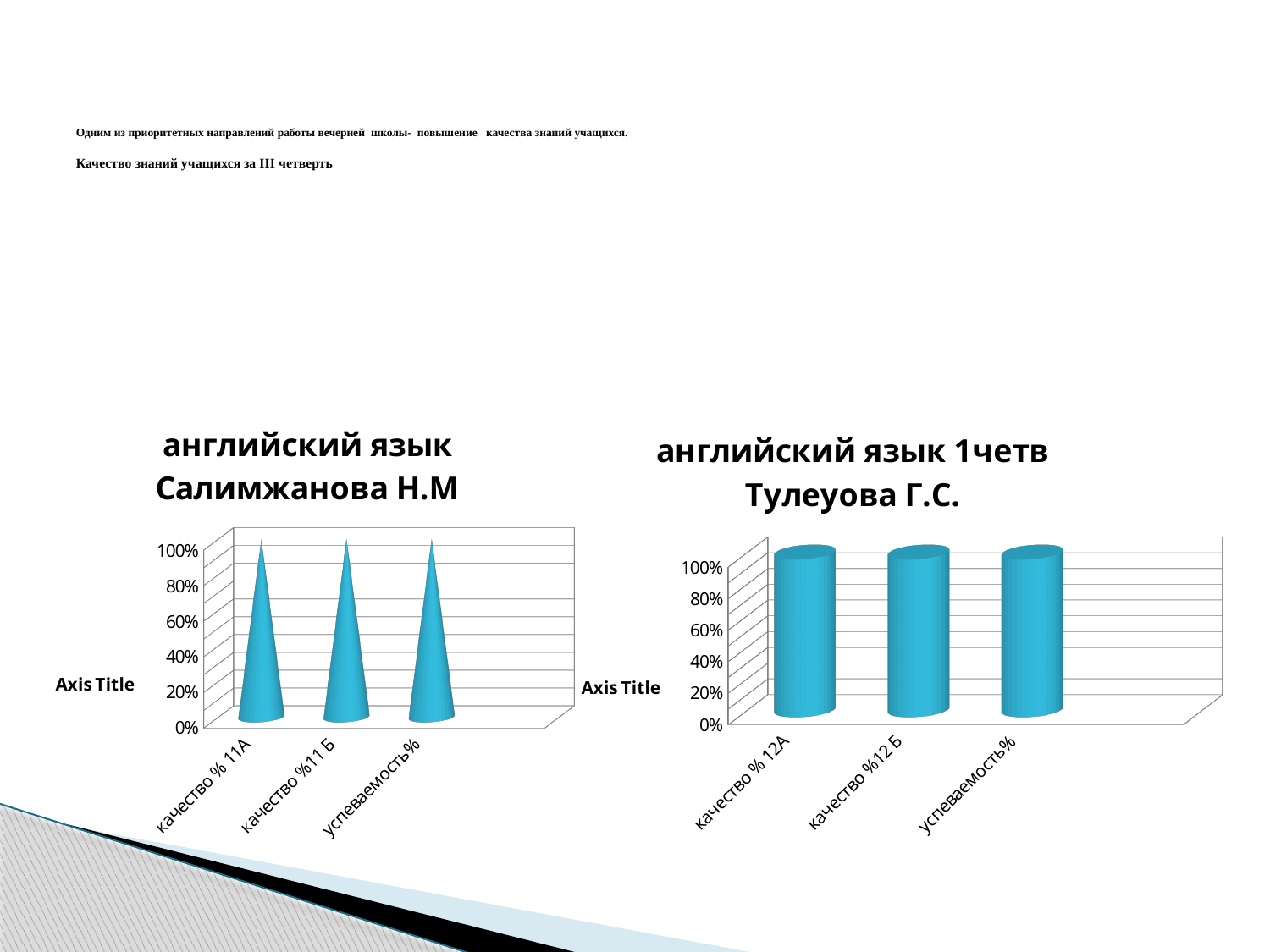
On the right chart (Тулеуова Г.С.), how many categories are shown on the x axis? 3 On the left chart (Салимжанова Н.М), is the value for успеваемость% greater or less than 60%? greater What kind of chart is the left chart (Салимжанова Н.М)? bar chart On the right chart (Тулеуова Г.С.), is the value for успеваемость% greater or less than 40%? greater What is the label of the vertical axis on the left chart? Axis Title On the left chart (Салимжанова Н.М), how many categories are shown on the x axis? 3 What kind of chart is the right chart (Тулеуова Г.С.)? bar chart What is the title of the right chart? английский язык 1четв Тулеуова Г.С.